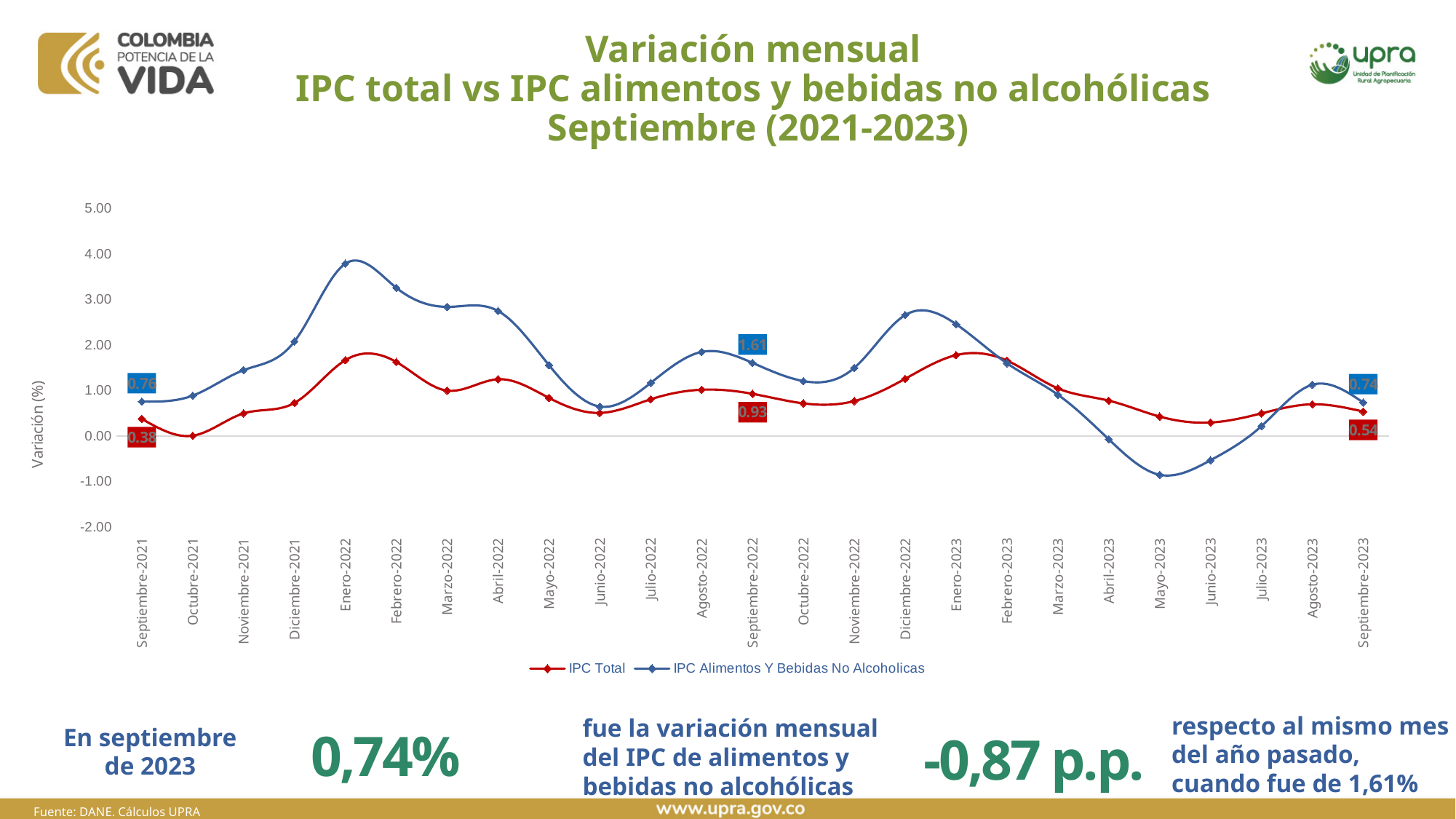
What is the value of IPC Total for Septiembre-2022? 0.93 What is the difference between IPC Alimentos Y Bebidas No Alcoholicas and IPC Total in Septiembre-2022? 0.68 What is the value of IPC Total for Septiembre-2021? 0.38 Which series has the higher value in Septiembre-2023, IPC Total or IPC Alimentos Y Bebidas No Alcoholicas? IPC Alimentos Y Bebidas No Alcoholicas By how much did IPC Alimentos Y Bebidas No Alcoholicas change from Septiembre-2022 to Septiembre-2023? -0.87 What is the value of IPC Alimentos Y Bebidas No Alcoholicas for Septiembre-2023? 0.74 What is the value of IPC Alimentos Y Bebidas No Alcoholicas for Septiembre-2021? 0.76 How many series does the legend list? 2 In which month does the IPC Alimentos Y Bebidas No Alcoholicas series reach its highest value? Enero-2022 Is the value of IPC Alimentos Y Bebidas No Alcoholicas for Enero-2022 greater or less than 3.00? greater What kind of chart is shown on the slide? line chart In which month does the IPC Alimentos Y Bebidas No Alcoholicas series reach its lowest value? Mayo-2023